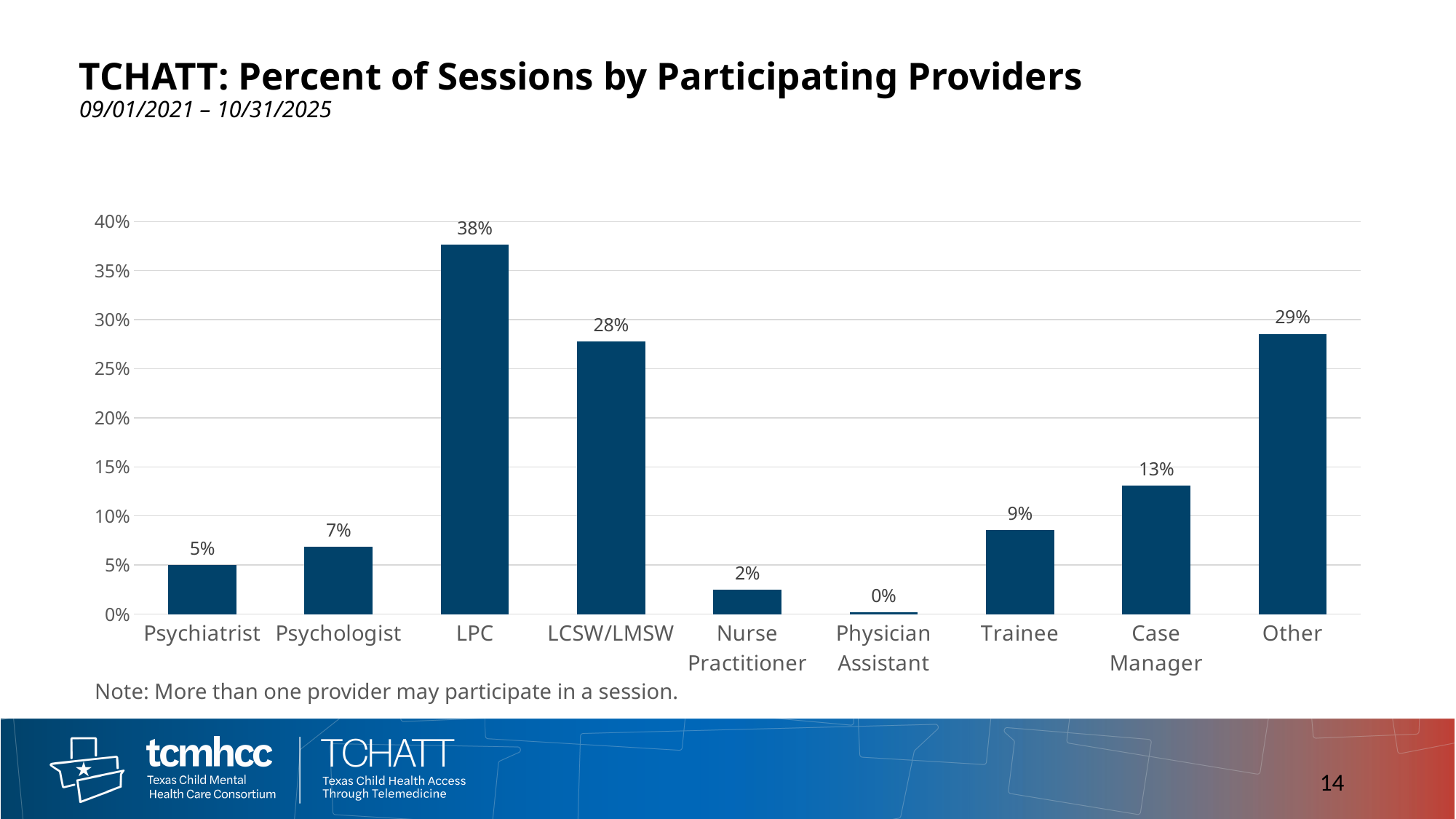
What is the value for Case Manager? 13% What is the difference between the values for LPC and LCSW/LMSW? 10% What is the value for Nurse Practitioner? 2% What percent of sessions had an LPC participating? 38% What kind of chart is shown on the slide? Bar chart What date range is shown under the chart title? 09/01/2021 – 10/31/2025 Which is larger, the value for Psychologist or the value for Psychiatrist? Psychologist What is the difference between the values for Other and Trainee? 20% How many provider categories are shown on the x axis? 9 Which provider type has the lowest percent of sessions? Physician Assistant Is the value for Other greater or less than 25%? greater Which provider type has the highest percent of sessions? LPC